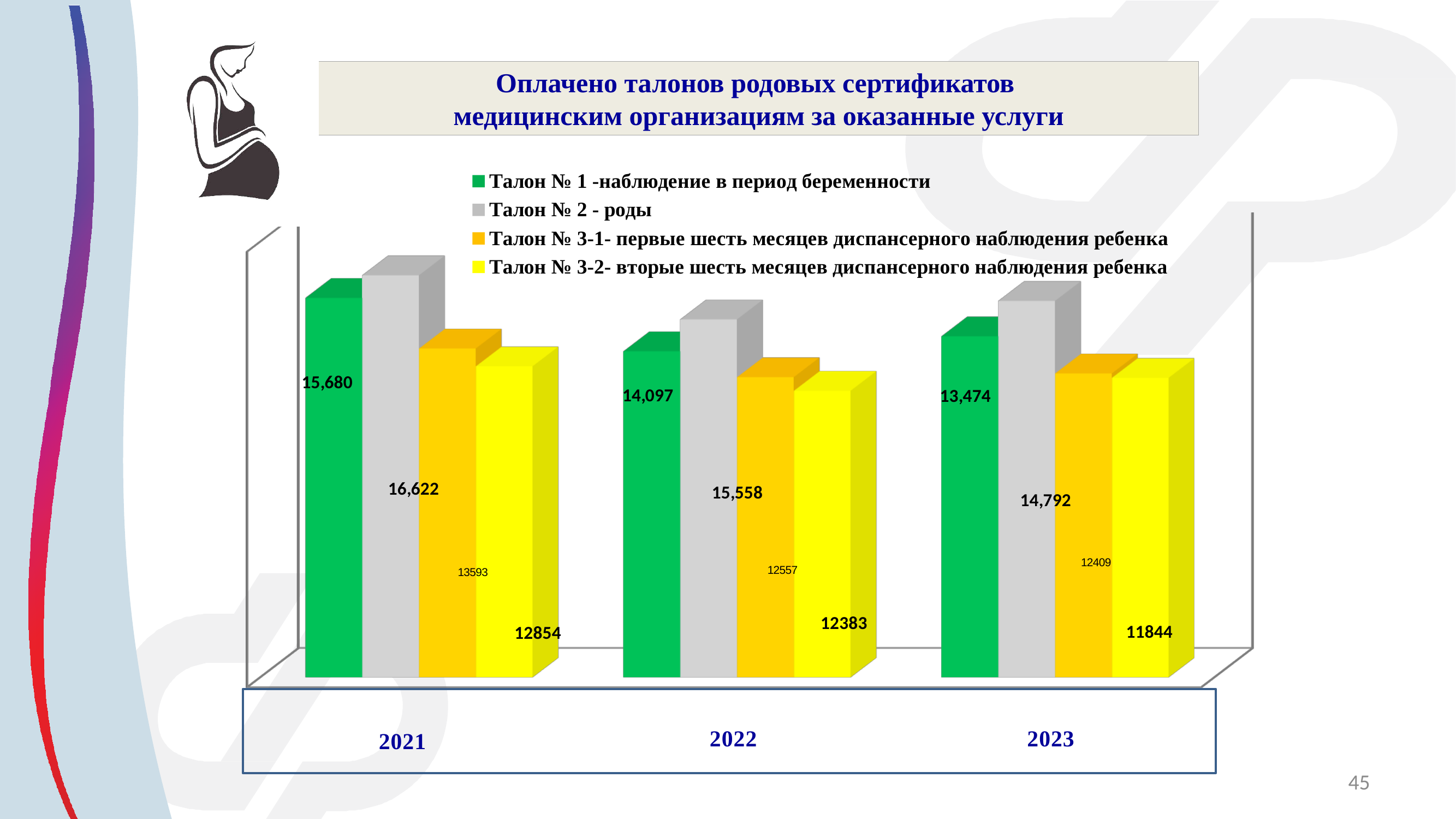
Do the values for Талон № 3-2- вторые шесть месяцев диспансерного наблюдения ребенка rise or fall from 2021 to 2023? Fall What is the value for Талон № 2 - роды in 2023? 14,792 What is the value for Талон № 3-1- первые шесть месяцев диспансерного наблюдения ребенка in 2022? 12557 What is the value for Талон № 1 -наблюдение в период беременности in 2021? 15,680 Which is larger in 2022: Талон № 1 -наблюдение в период беременности or Талон № 2 - роды? Талон № 2 - роды How many years are shown on the x axis? 3 What is the difference between the Талон № 2 - роды values for 2021 and 2022? 1,064 How many series does the legend list? 4 In which year is the value for Талон № 2 - роды the highest? 2021 What kind of chart is shown on the slide? Bar chart In which year is the value for Талон № 1 -наблюдение в период беременности the lowest? 2023 What is the value for Талон № 3-2- вторые шесть месяцев диспансерного наблюдения ребенка in 2023? 11844